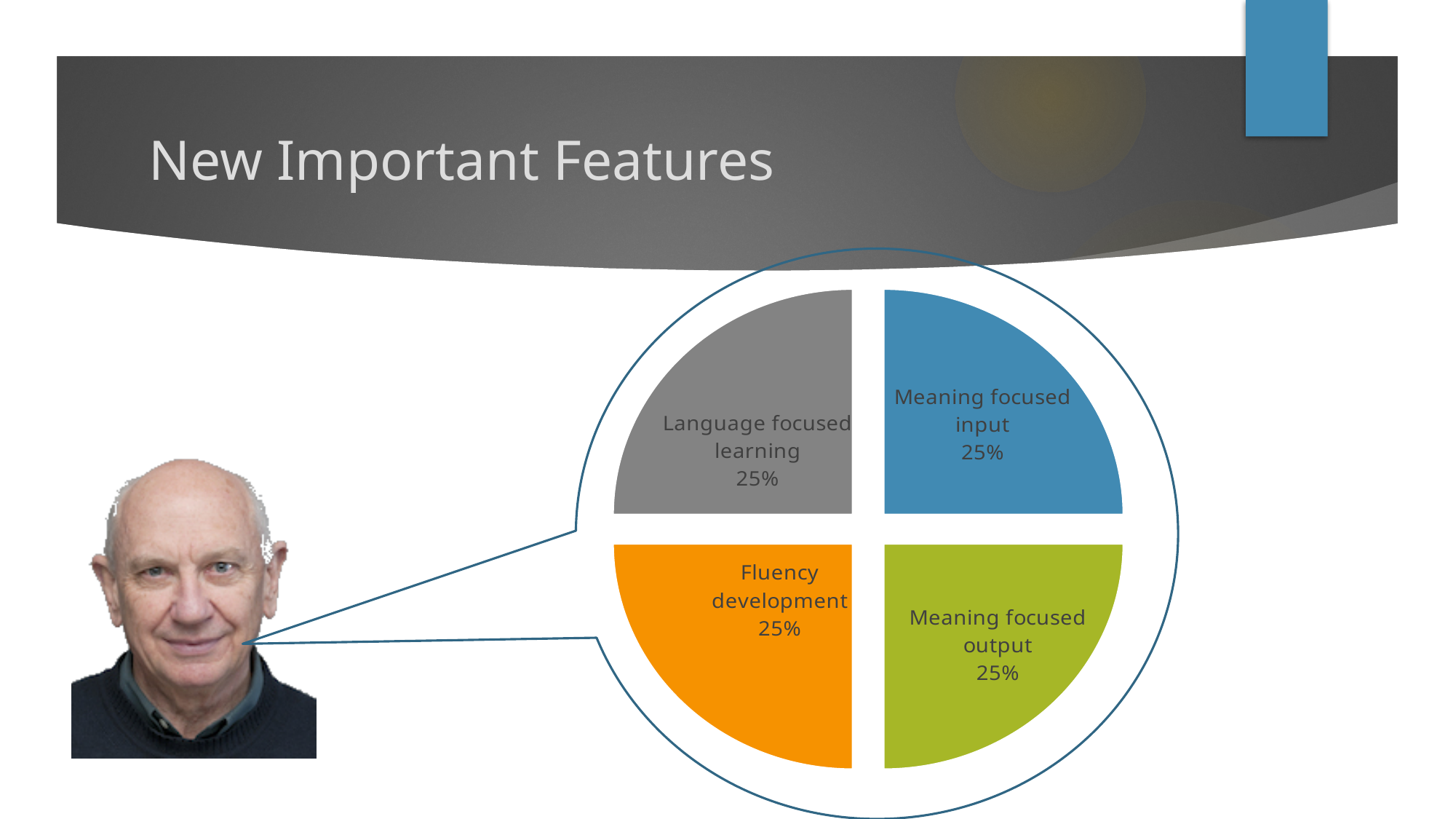
What is the total of all four slices in the pie chart? 100% Is the value for Meaning focused output greater or less than 50%? less What share of the pie does Meaning focused input have? 25% What is the value shown for Fluency development? 25% What is the difference between the values for Meaning focused input and Fluency development? 0% Which slice of the pie chart is coloured blue? Meaning focused input What kind of chart is shown on the slide? pie chart Which slice of the pie chart is coloured orange? Fluency development What is the value shown for Language focused learning? 25% What is the value shown for Meaning focused output? 25% How many slices does the pie chart have? 4